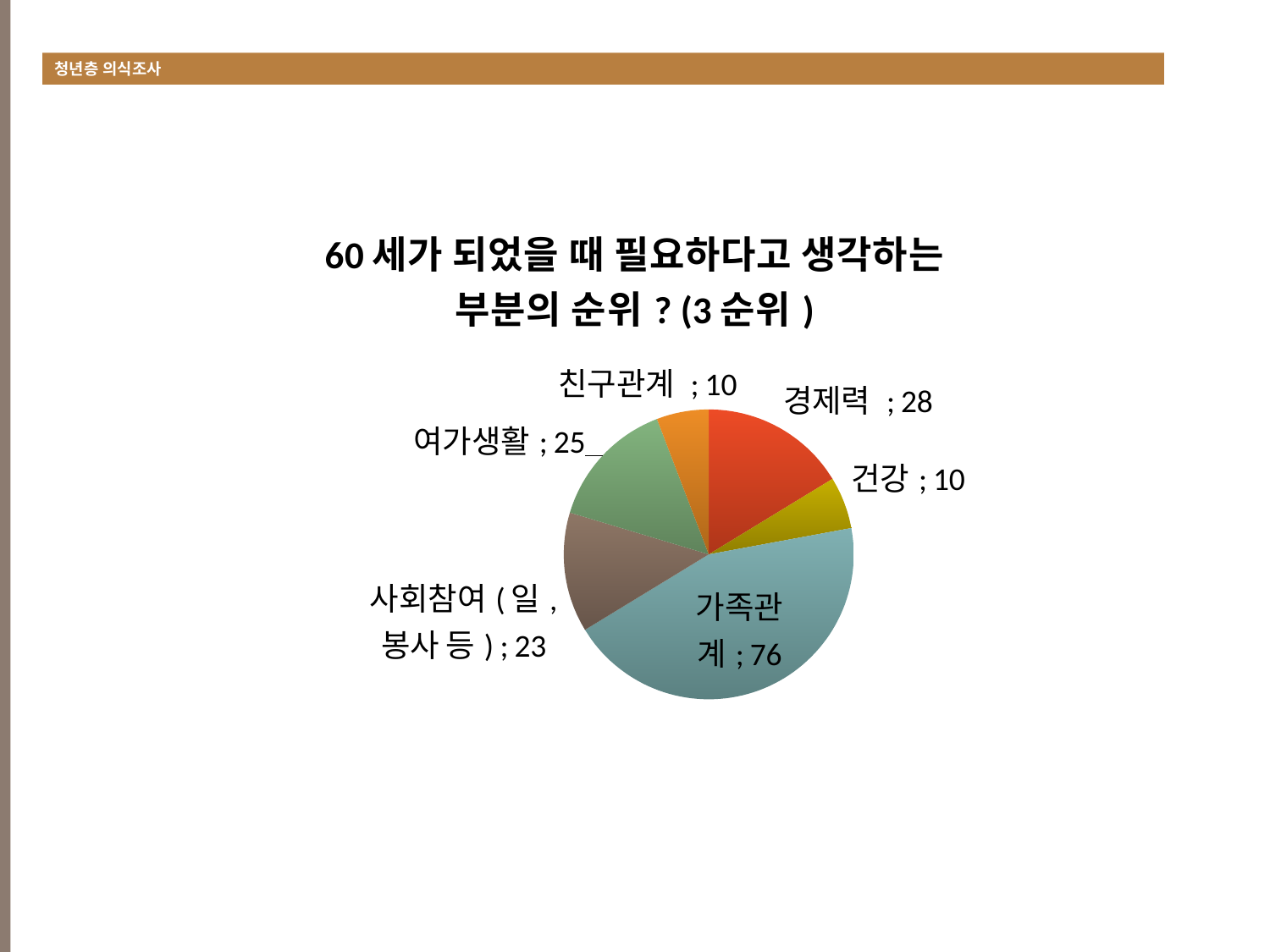
Which is larger, the value for 여가생활 or the value for 사회참여 (일, 봉사 등)? 여가생활 What is the value for 경제력? 28 What is the difference between the values for 가족관계 and 경제력? 48 What is the value for 사회참여 (일, 봉사 등)? 23 How many categories are shown in the pie chart? 6 What is the value for 건강? 10 Which category has the largest slice of the pie? 가족관계 Which two categories share the smallest value in the pie chart? 건강 and 친구관계 What kind of chart is shown on the slide? Pie chart What is the value for 가족관계 in the pie chart? 76 What is the title of the chart? 60 세가 되었을 때 필요하다고 생각하는 부분의 순위 ? (3 순위 ) What is the value for 여가생활? 25